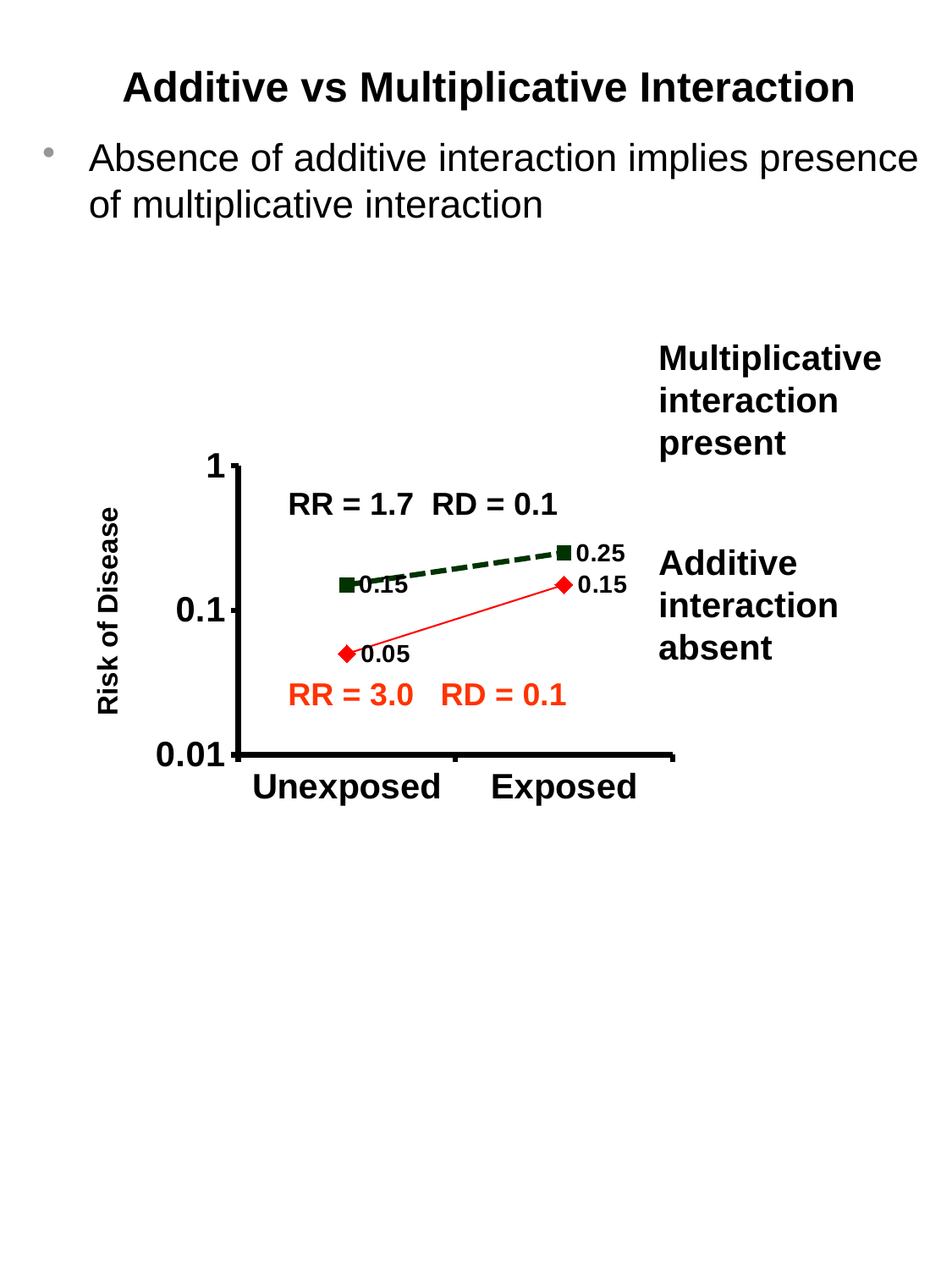
Which line has the higher value at Unexposed, the green dashed line or the red solid line? green dashed line Is the value of the red solid line at Unexposed greater or less than 0.1? less What is the value of the green dashed line at Exposed? 0.25 What is the value of the red solid line at Exposed? 0.15 What is the value of the red solid line at Unexposed? 0.05 What is the value of the green dashed line at Unexposed? 0.15 What is the difference between the Exposed and Unexposed values on the green dashed line? 0.1 What type of chart is shown on the slide? line chart What is the difference between the Exposed and Unexposed values on the red solid line? 0.1 How many categories are shown on the x axis? 2 What is the label of the y axis? Risk of Disease Do the values on the red solid line rise or fall from Unexposed to Exposed? rise